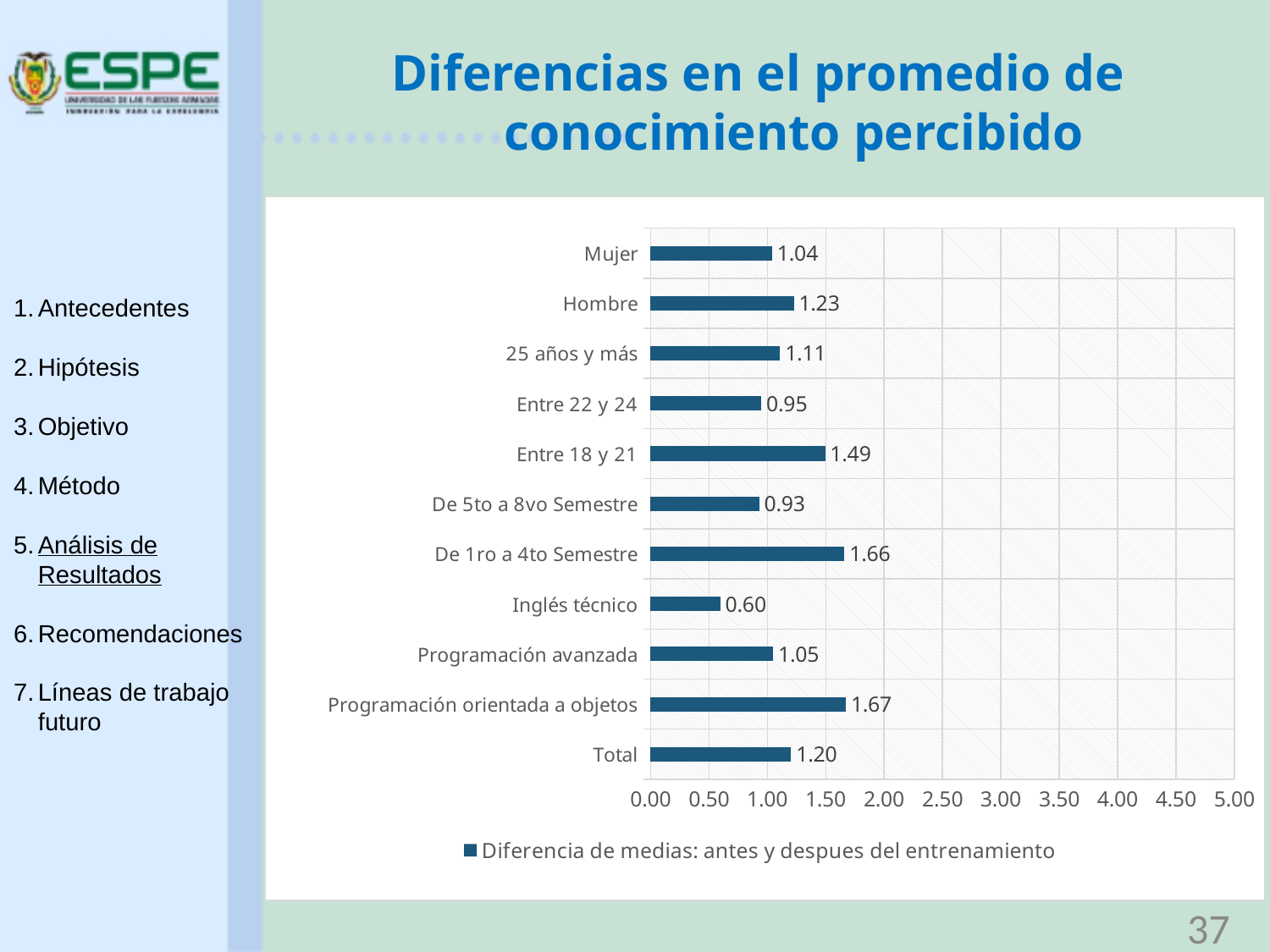
What is the difference between the values for Hombre and Mujer? 0.19 What is the value for Mujer? 1.04 How many categories are shown in the chart? 11 Is the value for Programación orientada a objetos greater or less than 1.50? greater What is the value for Inglés técnico? 0.60 Which has a larger value, Entre 18 y 21 or Entre 22 y 24? Entre 18 y 21 What kind of chart is shown on the slide? Bar chart What is the value for Entre 18 y 21? 1.49 What is the legend entry of the chart? Diferencia de medias: antes y despues del entrenamiento What is the difference between the values for De 1ro a 4to Semestre and De 5to a 8vo Semestre? 0.73 What is the value for Total? 1.20 Which category has the lowest value? Inglés técnico